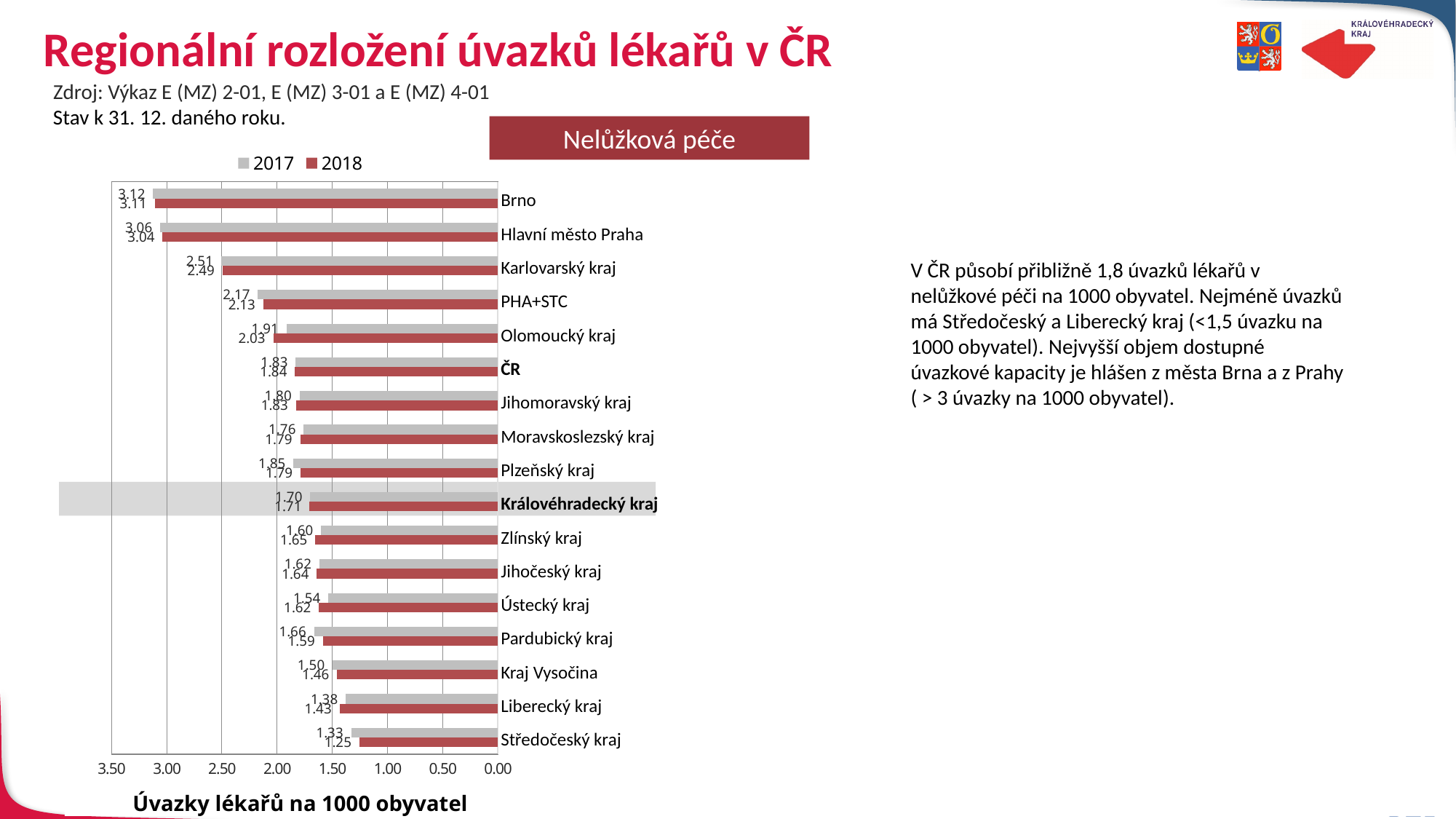
What is the 2018 value for ČR? 1.84 What is the title of the x-axis label below the chart? Úvazky lékařů na 1000 obyvatel What is the difference between the 2018 values for Brno and Středočeský kraj? 1.86 What is the difference between the 2017 and 2018 values for Olomoucký kraj? 0.12 Which is larger, the 2018 value for Karlovarský kraj or the 2018 value for PHA+STC? Karlovarský kraj Which region has the lowest 2018 value? Středočeský kraj What is the 2017 value for Olomoucký kraj? 1.91 What is the 2018 value for Královéhradecký kraj? 1.71 What type of chart is shown on the slide? bar chart Which region has the highest 2018 value? Brno How many categories are shown on the chart? 17 How many series does the chart legend list? 2